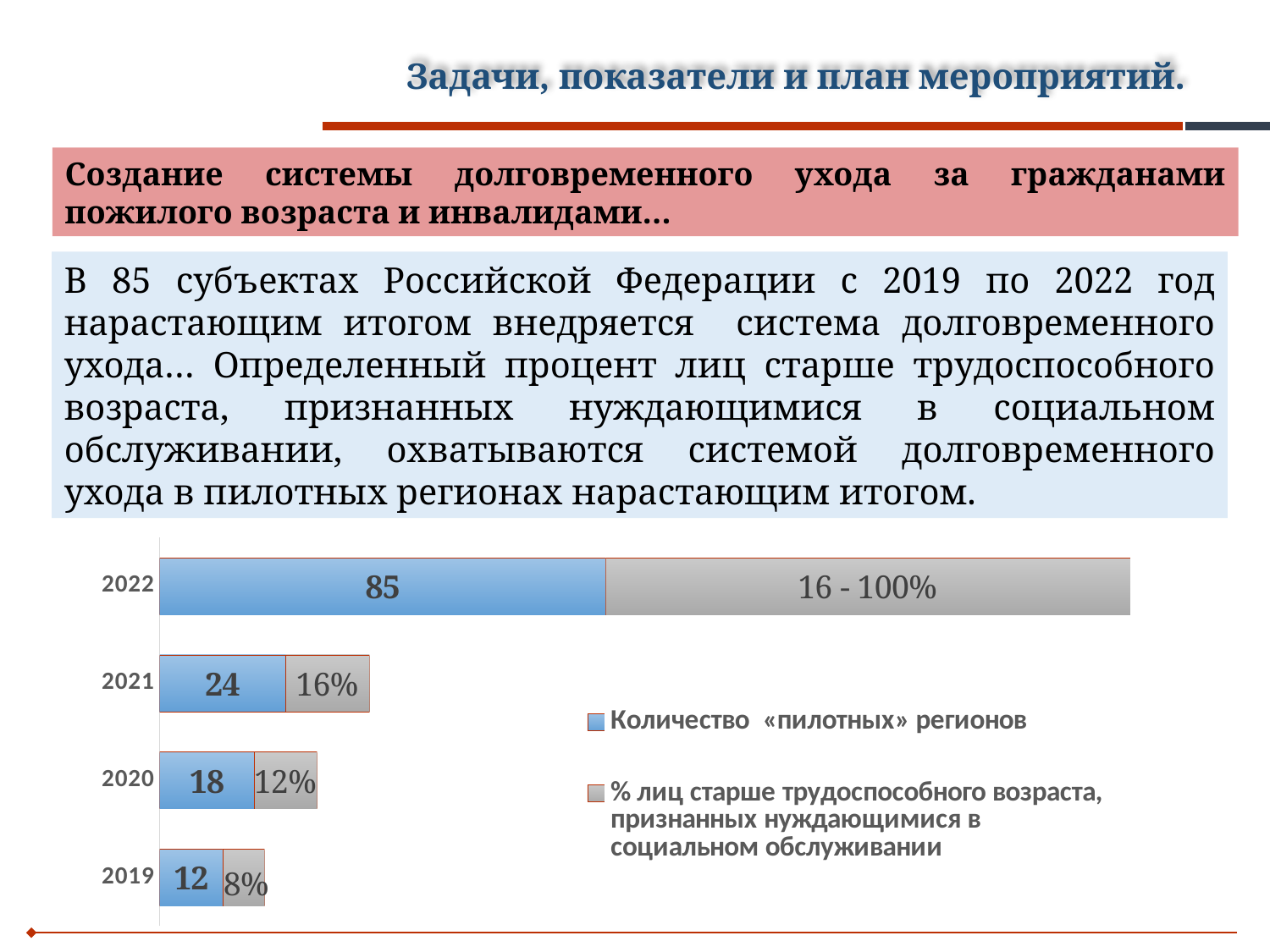
What percentage label is shown for 2021 in the grey series (% лиц старше трудоспособного возраста)? 16% How many years (categories) are shown in the chart? 4 Which year has the highest number of pilot regions? 2022 What is the difference between the number of pilot regions in 2022 and in 2021? 61 Which year has the lowest number of pilot regions? 2019 What is the number of pilot regions (Количество «пилотных» регионов) shown for 2022? 85 What label is shown on the grey segment for 2022? 16 - 100% What is the number of pilot regions shown for 2019? 12 Which year has more pilot regions, 2020 or 2021? 2021 What is the difference between the number of pilot regions in 2020 and in 2019? 6 How many series does the legend list? 2 What percentage is shown for 2020 in the grey series? 12%